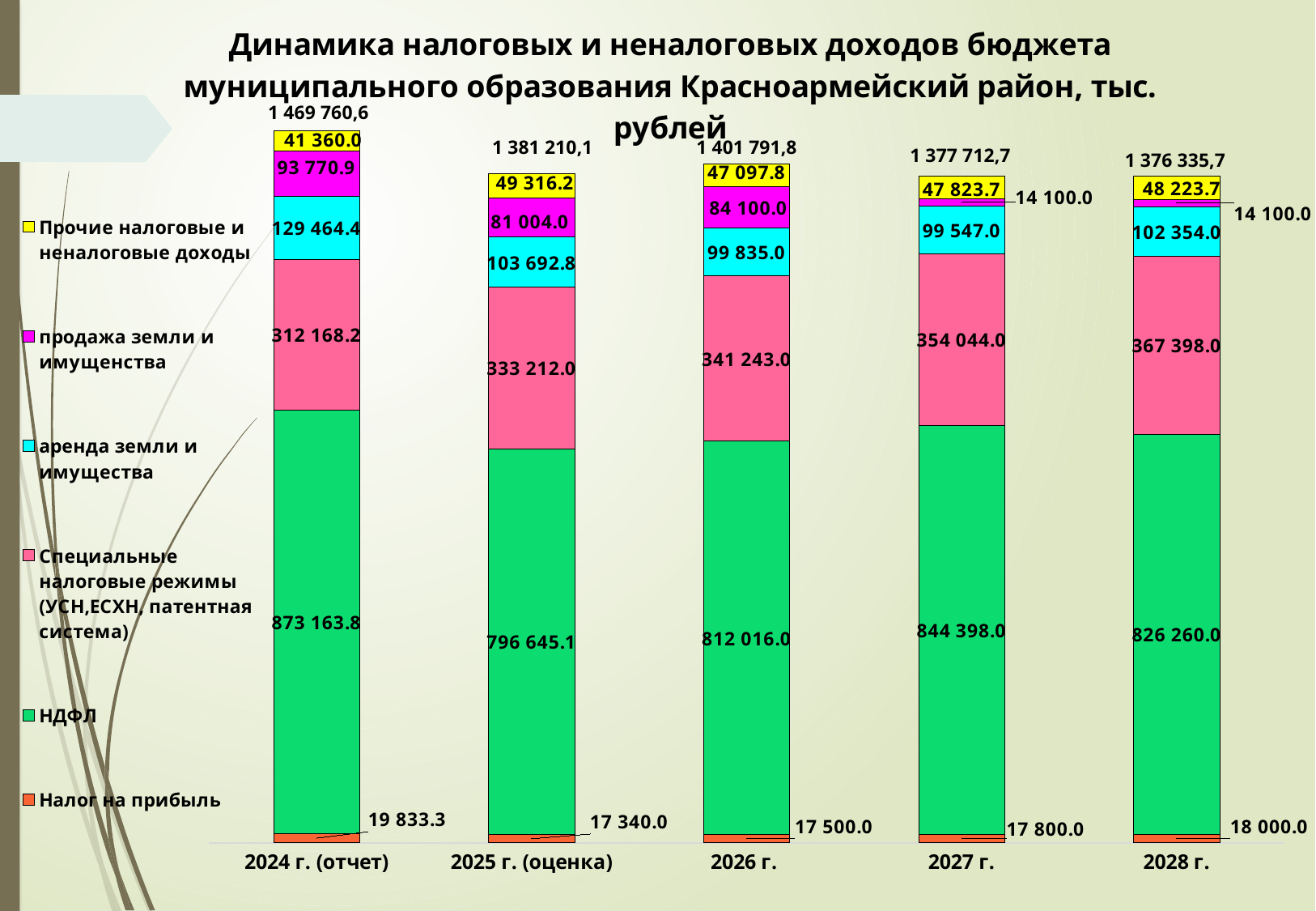
What kind of chart is shown on the slide? Stacked bar chart Which is larger: Прочие налоговые и неналоговые доходы in 2025 г. (оценка) or in 2026 г.? 2025 г. (оценка) What is the total of the stacked bar for 2026 г.? 1 401 791,8 How many series does the legend list? 6 What is the value of НДФЛ for 2024 г. (отчет)? 873 163.8 What is the value of Налог на прибыль for 2028 г.? 18 000.0 In which year is the value of НДФЛ the lowest? 2025 г. (оценка) In which year is the value of Специальные налоговые режимы (УСН,ЕСХН, патентная система) the highest? 2028 г. How many years (categories) are shown on the x axis? 5 What is the difference between the Налог на прибыль values for 2024 г. (отчет) and 2025 г. (оценка)? 2 493.3 What is the value of продажа земли и имущенства for 2027 г.? 14 100.0 What is the value of аренда земли и имущества for 2025 г. (оценка)? 103 692.8